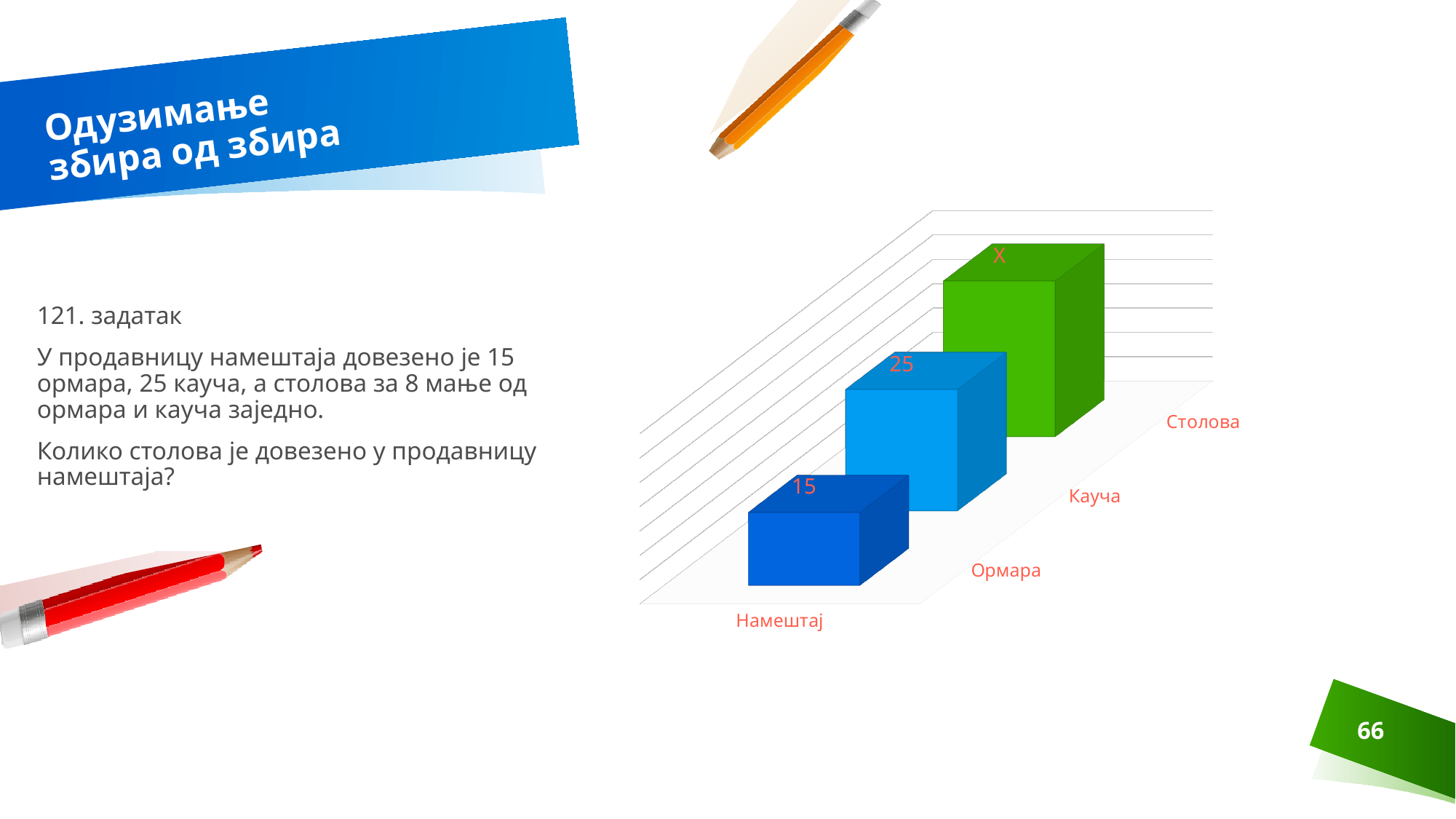
Which category has the shortest bar? Ормара What value is labelled on the bar for Кауча? 25 What colour is the bar for Столова? Green Which category has the tallest bar? Столова What label is shown on the bar for Столова? X Which is larger, the value for Кауча or the value for Ормара? Кауча Do the bars rise or fall from Ормара to Столова? Rise What kind of chart is shown on the slide? Bar chart How many categories are shown in the chart? 3 What value is labelled on the bar for Ормара? 15 What is the difference between the values for Кауча and Ормара? 10 What is the label of the category axis of the chart? Намештај